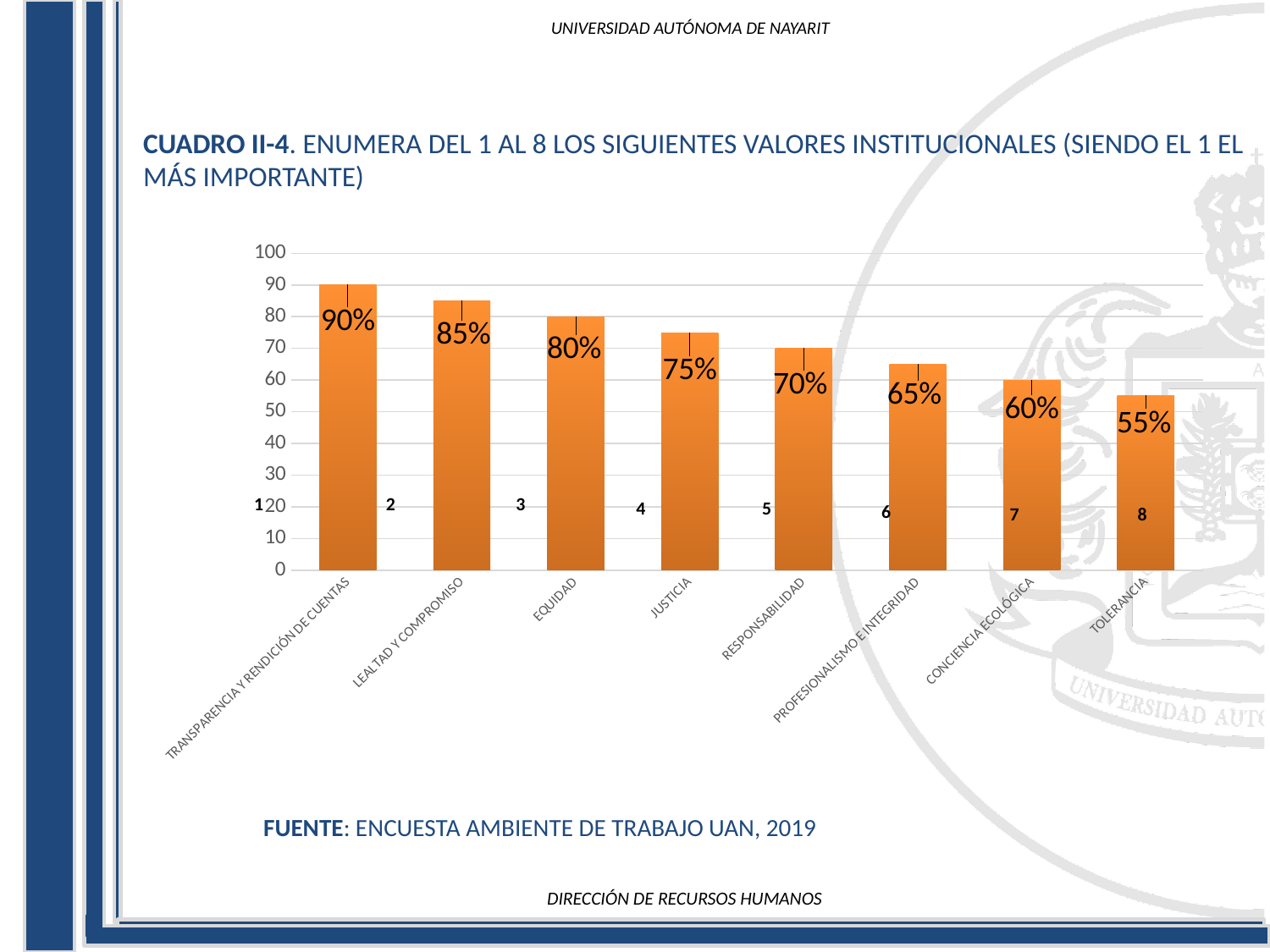
What source is cited below the chart? ENCUESTA AMBIENTE DE TRABAJO UAN, 2019 Which is larger, the value for CONCIENCIA ECOLÓGICA or the value for PROFESIONALISMO E INTEGRIDAD? PROFESIONALISMO E INTEGRIDAD Which category has the highest value? TRANSPARENCIA Y RENDICIÓN DE CUENTAS What is the difference between the values for LEALTAD Y COMPROMISO and JUSTICIA? 10% Is the value for JUSTICIA greater or less than 70? greater What is the value for TOLERANCIA? 55% Which category has the lowest value? TOLERANCIA How many categories are shown on the x axis? 8 What is the value for EQUIDAD? 80% What is the value for RESPONSABILIDAD? 70% What kind of chart is shown on the slide? bar chart Do the values rise or fall from left to right along the x axis? fall